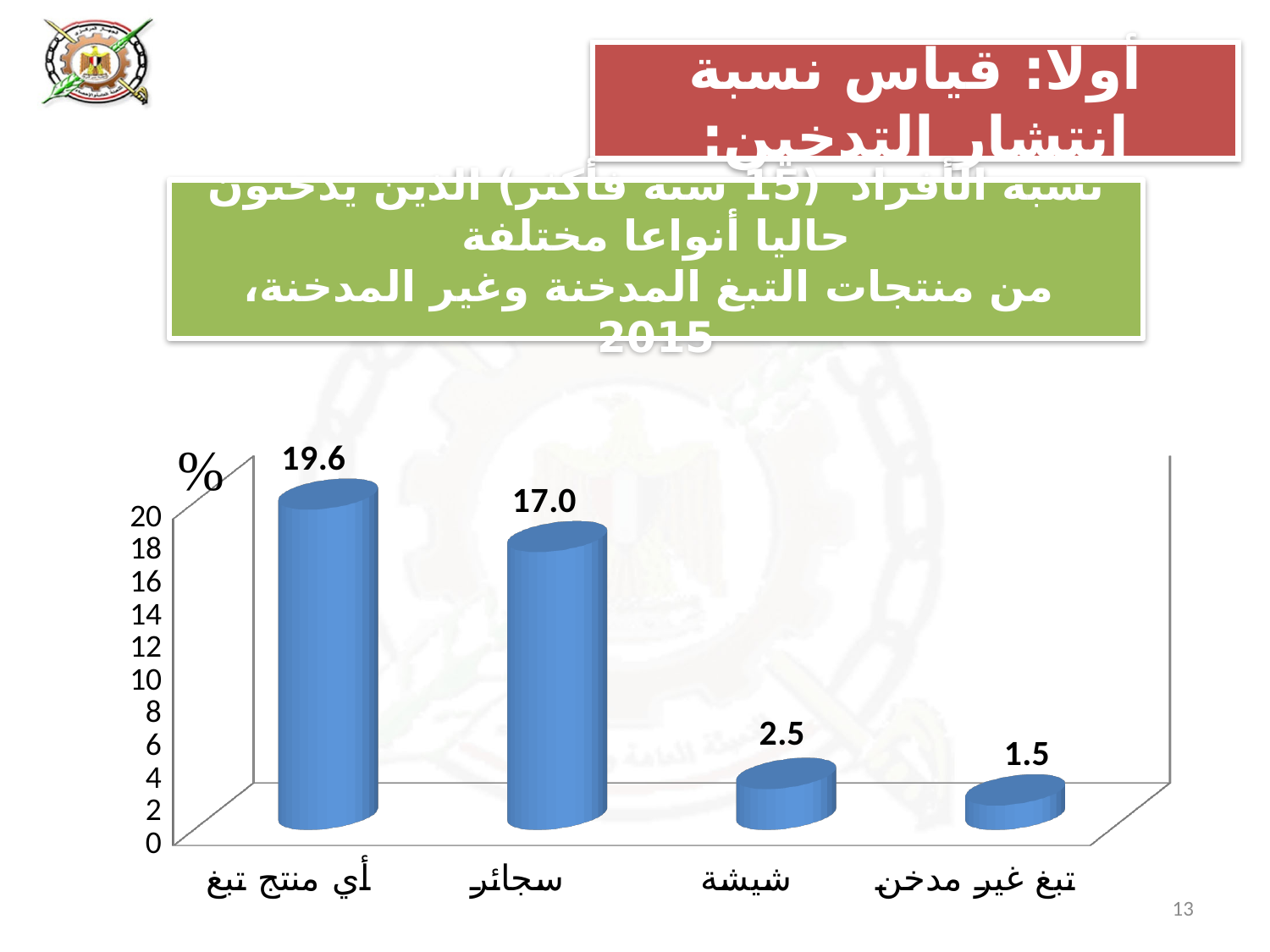
Which category has the lowest value? تبغ غير مدخن Which category has the highest value? أي منتج تبغ How many categories are shown on the chart? 4 What is the difference between the values for أي منتج تبغ and سجائر? 2.6 What is the value for شيشة? 2.5 What is the value for أي منتج تبغ? 19.6 What is the value for تبغ غير مدخن? 1.5 What is the difference between the values for شيشة and تبغ غير مدخن? 1.0 What unit symbol is shown at the top of the vertical axis? % What is the value for سجائر? 17.0 Which is larger, the value for سجائر or the value for شيشة? سجائر What kind of chart is shown on the slide? bar chart